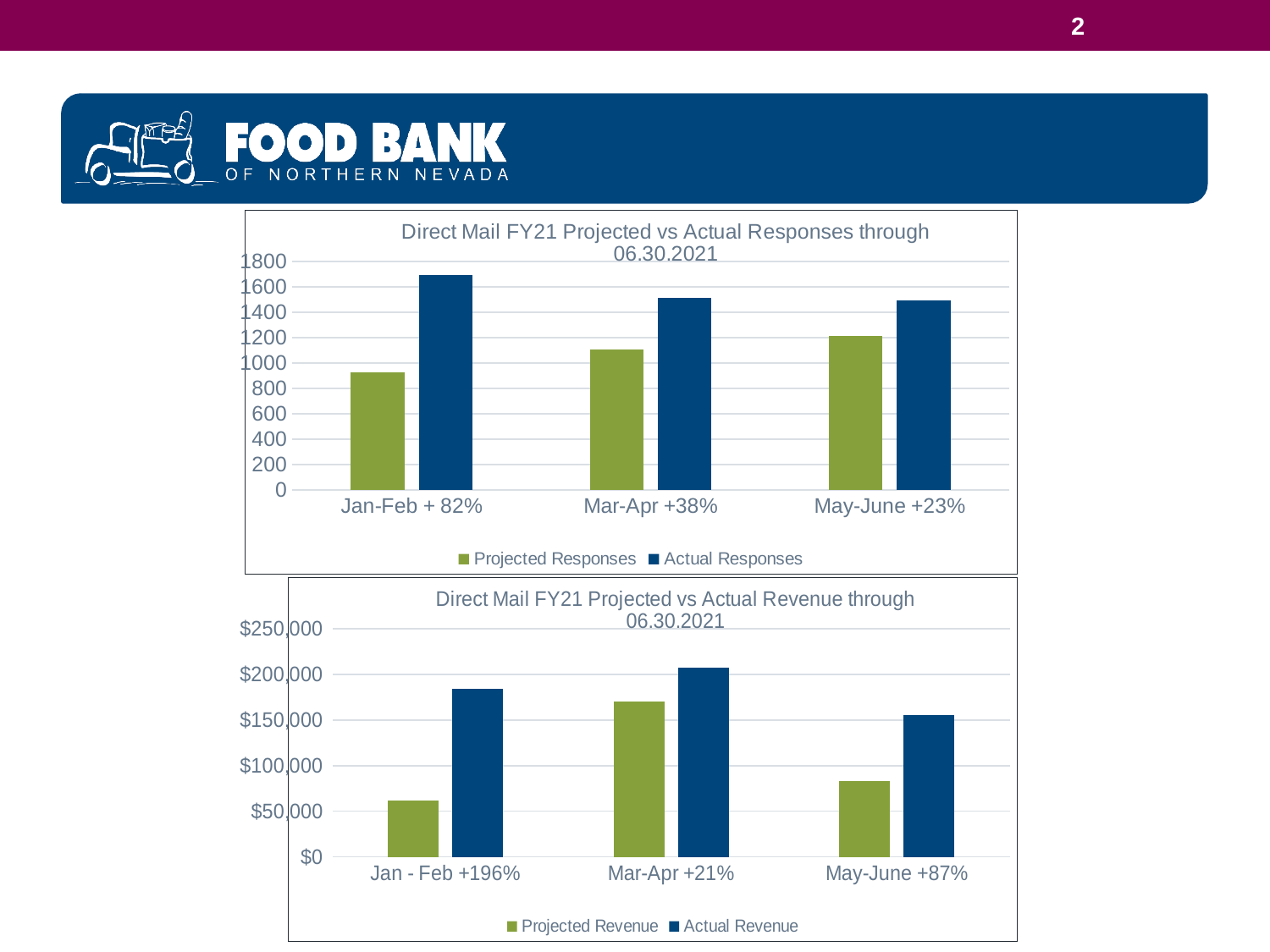
In the bottom chart (Projected vs Actual Revenue), which category has the highest Projected Revenue? Mar-Apr +21% In the top chart (Projected vs Actual Responses), which category has the lowest Projected Responses? Jan-Feb + 82% In the top chart (Projected vs Actual Responses), do the Projected Responses rise or fall from Jan-Feb to May-June? rise In the top chart (Projected vs Actual Responses), which category has the highest Actual Responses? Jan-Feb + 82% In the top chart (Projected vs Actual Responses), is the Actual Responses value for Jan-Feb + 82% greater or less than 1600? greater In the top chart (Projected vs Actual Responses), is the Projected Responses value for Jan-Feb + 82% greater or less than 1000? less In the top chart (Projected vs Actual Responses), how many series does the legend list? 2 In the bottom chart (Projected vs Actual Revenue), is the Actual Revenue for Mar-Apr +21% greater or less than $200,000? greater In the top chart (Projected vs Actual Responses), how many categories are shown on the x axis? 3 What kind of chart is the top chart, 'Direct Mail FY21 Projected vs Actual Responses through 06.30.2021'? Bar chart In the bottom chart (Projected vs Actual Revenue), which is larger for May-June +87%: Projected Revenue or Actual Revenue? Actual Revenue